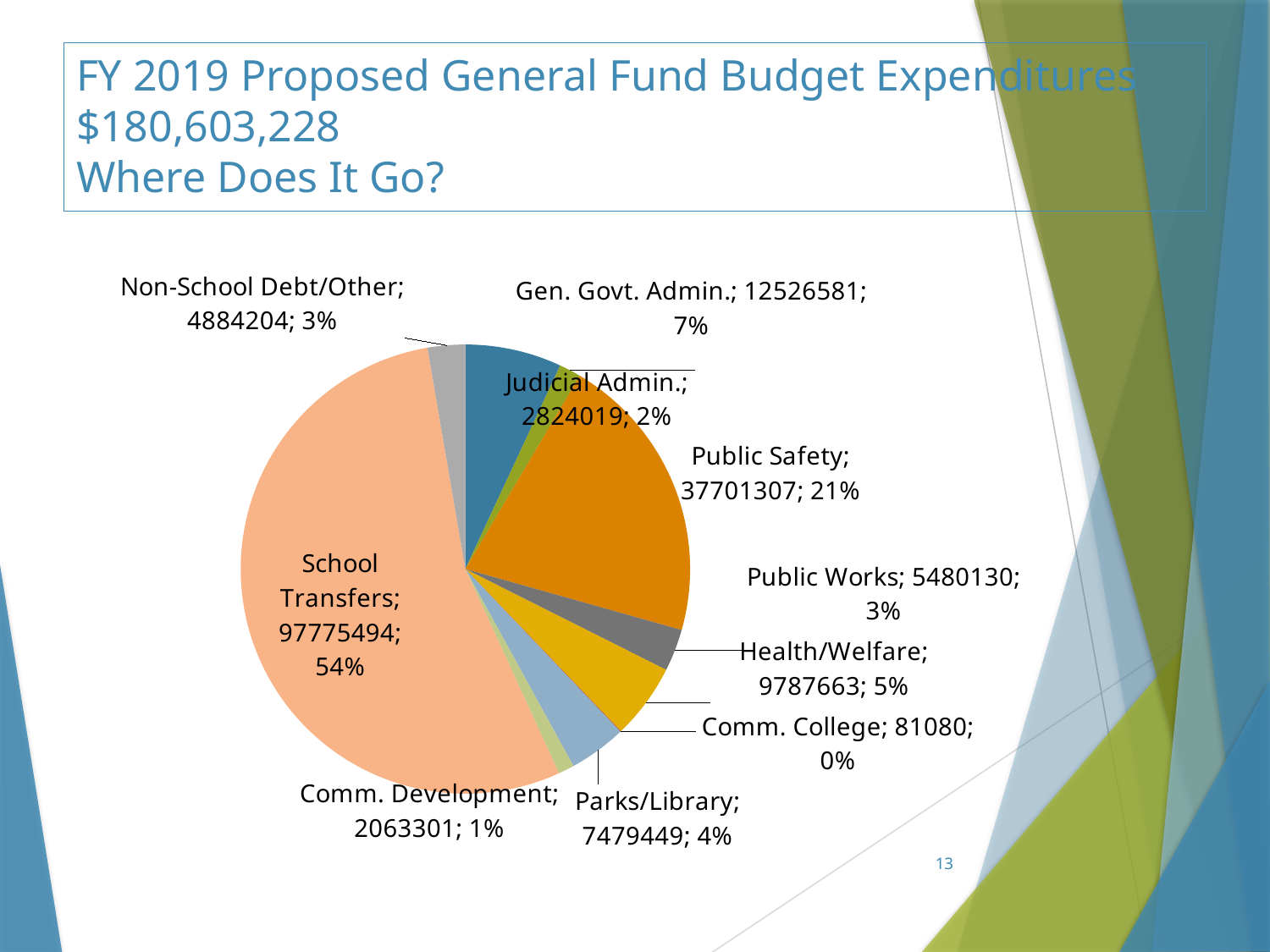
What is the value for School Transfers? 97775494 What is the difference between the values for Public Safety and Gen. Govt. Admin.? 25174726 Which category has the largest slice? School Transfers What share of the pie does Gen. Govt. Admin. represent? 7% What is the value for Health/Welfare? 9787663 What kind of chart is shown on the slide? pie chart Which is larger, the value for Public Works or the value for Non-School Debt/Other? Public Works What share of the pie does Parks/Library represent? 4% What is the value for Public Safety? 37701307 What total expenditure amount is stated in the slide title? $180,603,228 Which category has the smallest slice? Comm. College How many categories are shown in the pie chart? 10